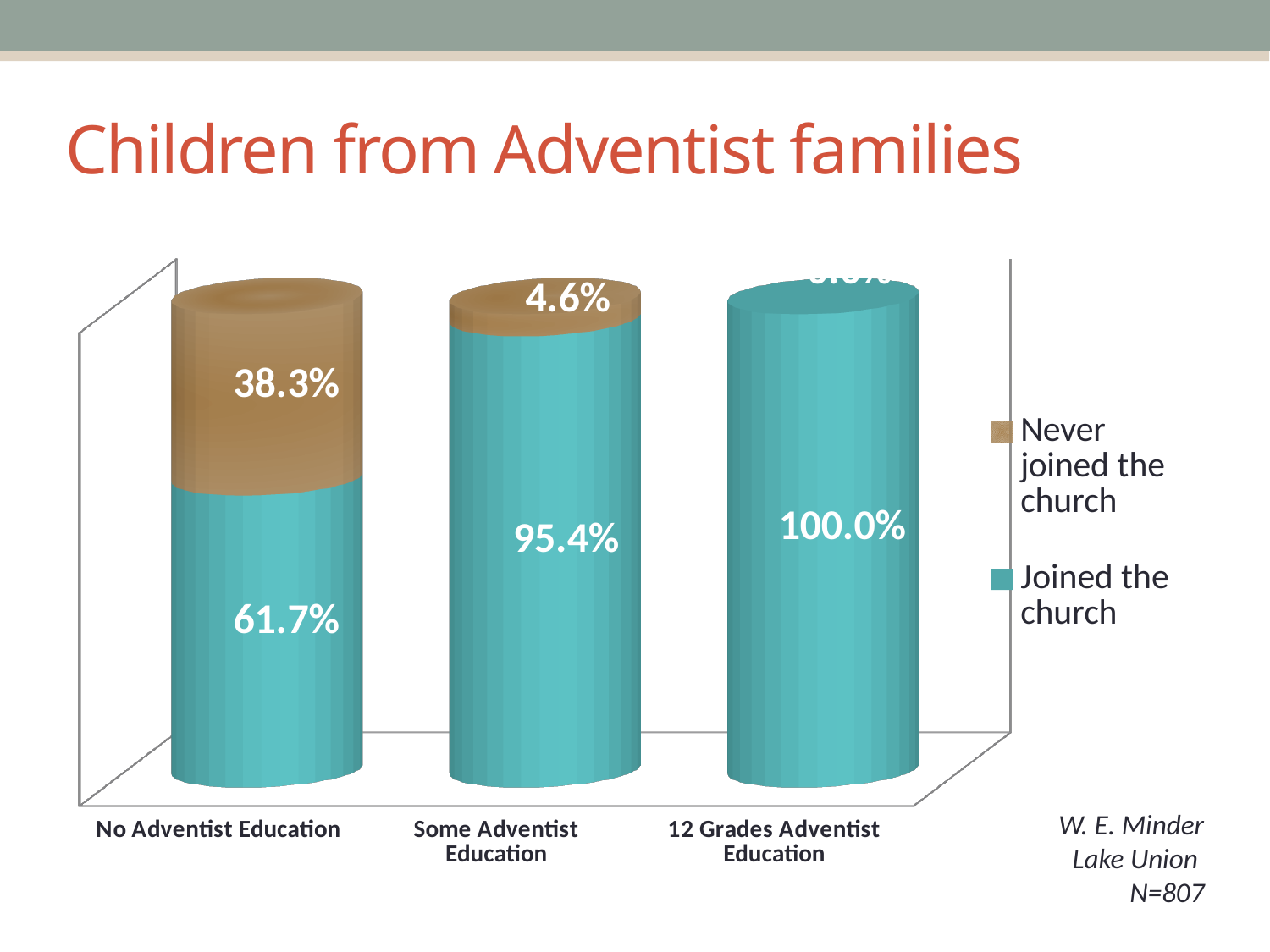
How many series does the legend list? 2 What is the difference between the 'Joined the church' percentages for Some Adventist Education and No Adventist Education? 33.7% What percentage of children with Some Adventist Education never joined the church? 4.6% What percentage of children with No Adventist Education joined the church? 61.7% Which category has the highest percentage of children who joined the church? 12 Grades Adventist Education What percentage of children with Some Adventist Education joined the church? 95.4% What kind of chart is shown on the slide? Stacked bar chart What percentage of children with No Adventist Education never joined the church? 38.3% What percentage of children with 12 Grades Adventist Education joined the church? 100.0% Which category has the lowest percentage of children who joined the church? No Adventist Education Which is larger: the 'Never joined the church' share for No Adventist Education or for Some Adventist Education? No Adventist Education How many education categories are shown on the x axis? 3